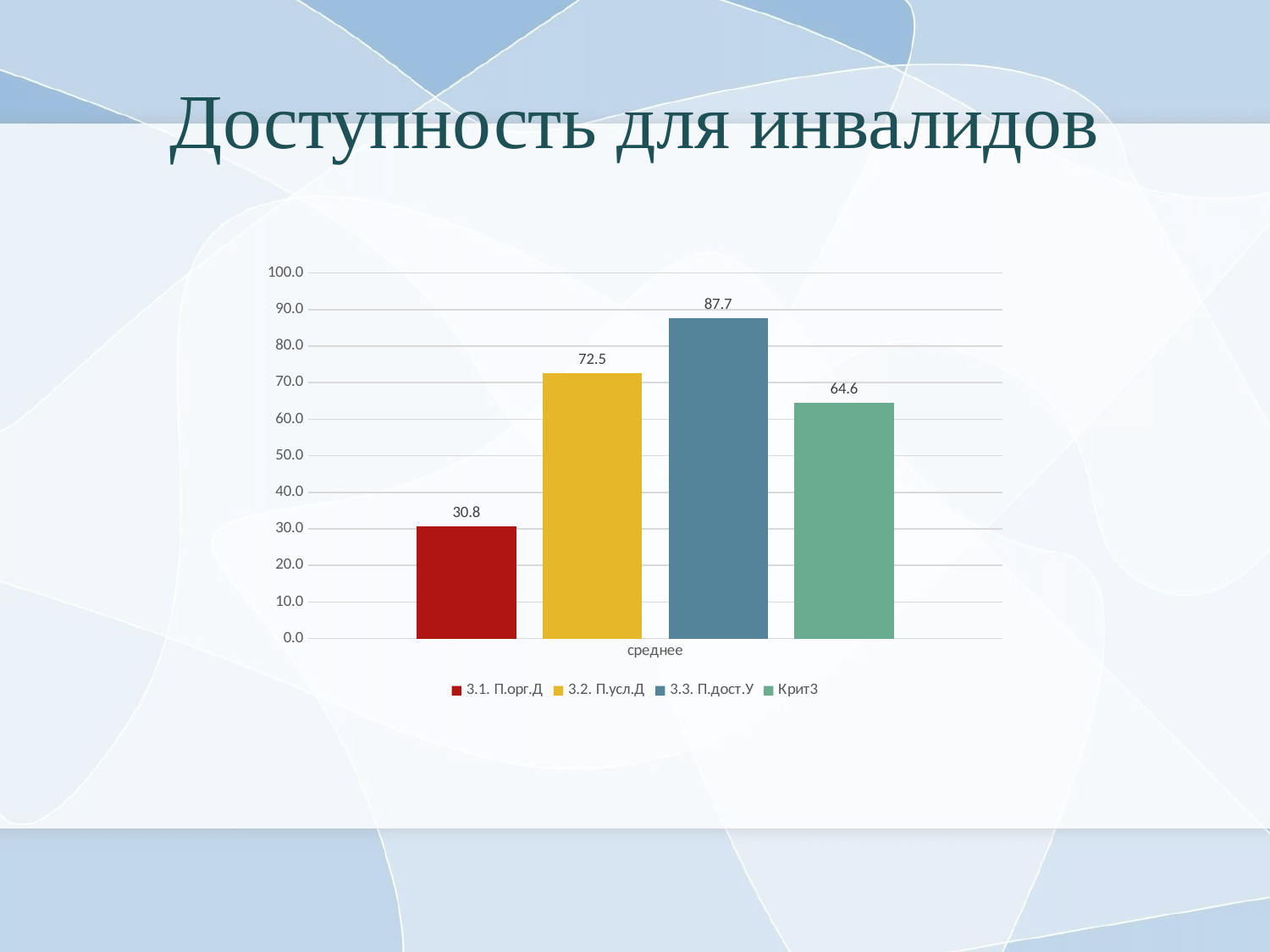
What kind of chart is shown on the slide? bar chart What is the value for 3.3. П.дост.У? 87.7 Which series has the highest value? 3.3. П.дост.У What is the value for Крит3? 64.6 Which series has the lowest value? 3.1. П.орг.Д What is the difference between the values for 3.2. П.усл.Д and Крит3? 7.9 What is the title of the slide containing the chart? Доступность для инвалидов What is the value for 3.2. П.усл.Д? 72.5 What is the value for 3.1. П.орг.Д? 30.8 What is the difference between the values for 3.3. П.дост.У and 3.1. П.орг.Д? 56.9 Which is larger, the value for 3.2. П.усл.Д or the value for Крит3? 3.2. П.усл.Д How many series does the legend list? 4